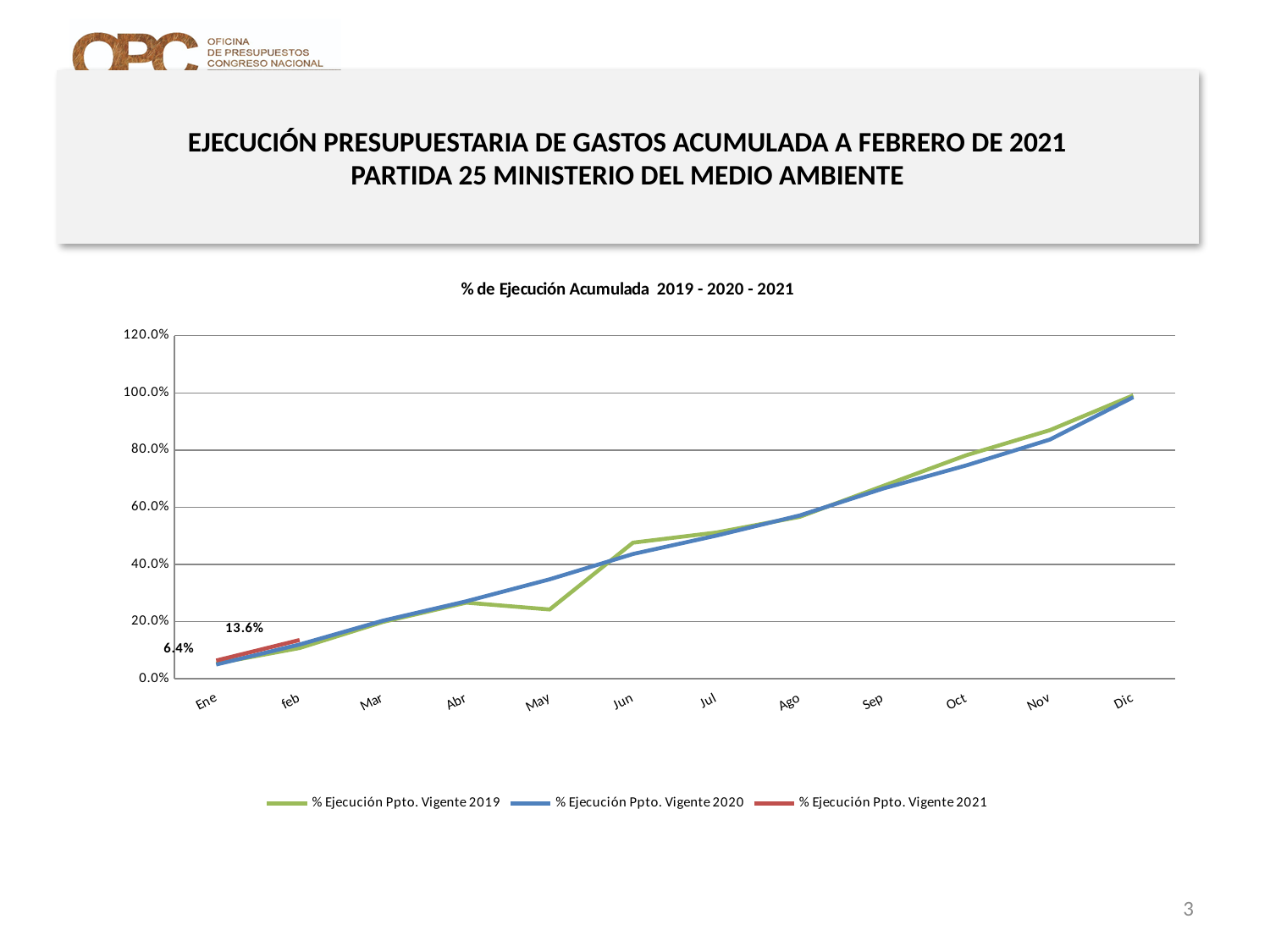
What is the value for % Ejecución Ppto. Vigente 2021 in Feb? 13.6% Which series is drawn in red? % Ejecución Ppto. Vigente 2021 How many months are shown along the x axis? 12 In May, which series has the larger value: % Ejecución Ppto. Vigente 2019 or % Ejecución Ppto. Vigente 2020? % Ejecución Ppto. Vigente 2020 How many series does the legend list? 3 What is the difference between the Feb and Ene values for % Ejecución Ppto. Vigente 2021? 7.2% What kind of chart is shown on the slide? line chart Is the value for % Ejecución Ppto. Vigente 2019 in May greater or less than 40.0%? less What is the title of the chart? % de Ejecución Acumulada 2019 - 2020 - 2021 Do the values for % Ejecución Ppto. Vigente 2020 rise or fall from Ene to Dic? rise Is the value for % Ejecución Ppto. Vigente 2020 in Dic greater or less than 80.0%? greater What is the value for % Ejecución Ppto. Vigente 2021 in Ene? 6.4%